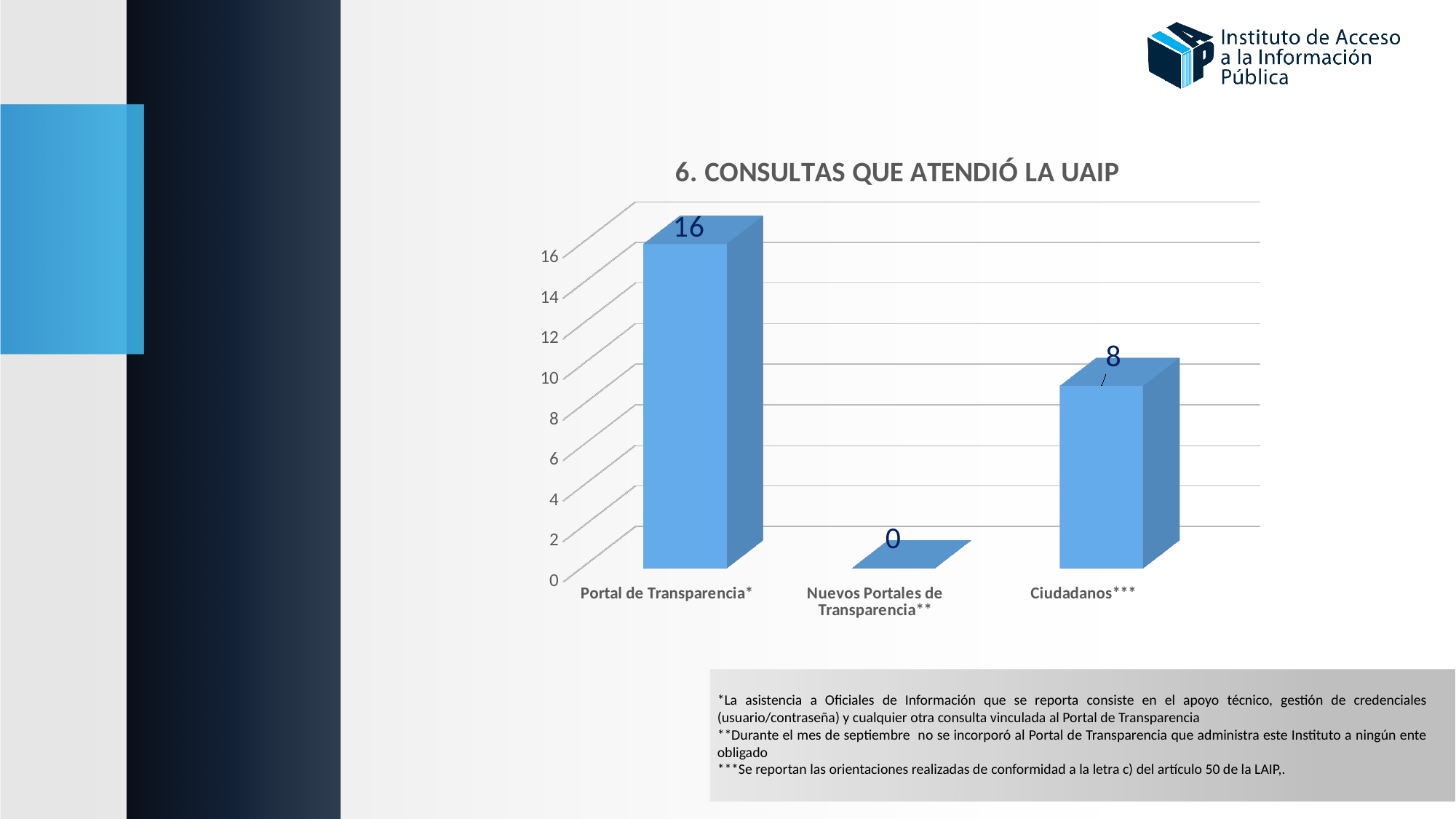
Which category has the lowest value? Nuevos Portales de Transparencia** What is the difference between the values for Portal de Transparencia* and Ciudadanos***? 8 What is the value for Portal de Transparencia*? 16 What is the value for Nuevos Portales de Transparencia**? 0 What is the total of the three values shown on the chart? 24 What is the title of the chart? 6. CONSULTAS QUE ATENDIÓ LA UAIP How many categories are shown on the chart? 3 What is the value for Ciudadanos***? 8 Which is larger, the value for Ciudadanos*** or the value for Nuevos Portales de Transparencia**? Ciudadanos*** Is the value for Portal de Transparencia* greater or less than 10? greater Which category has the highest value? Portal de Transparencia* What kind of chart is shown on the slide? bar chart